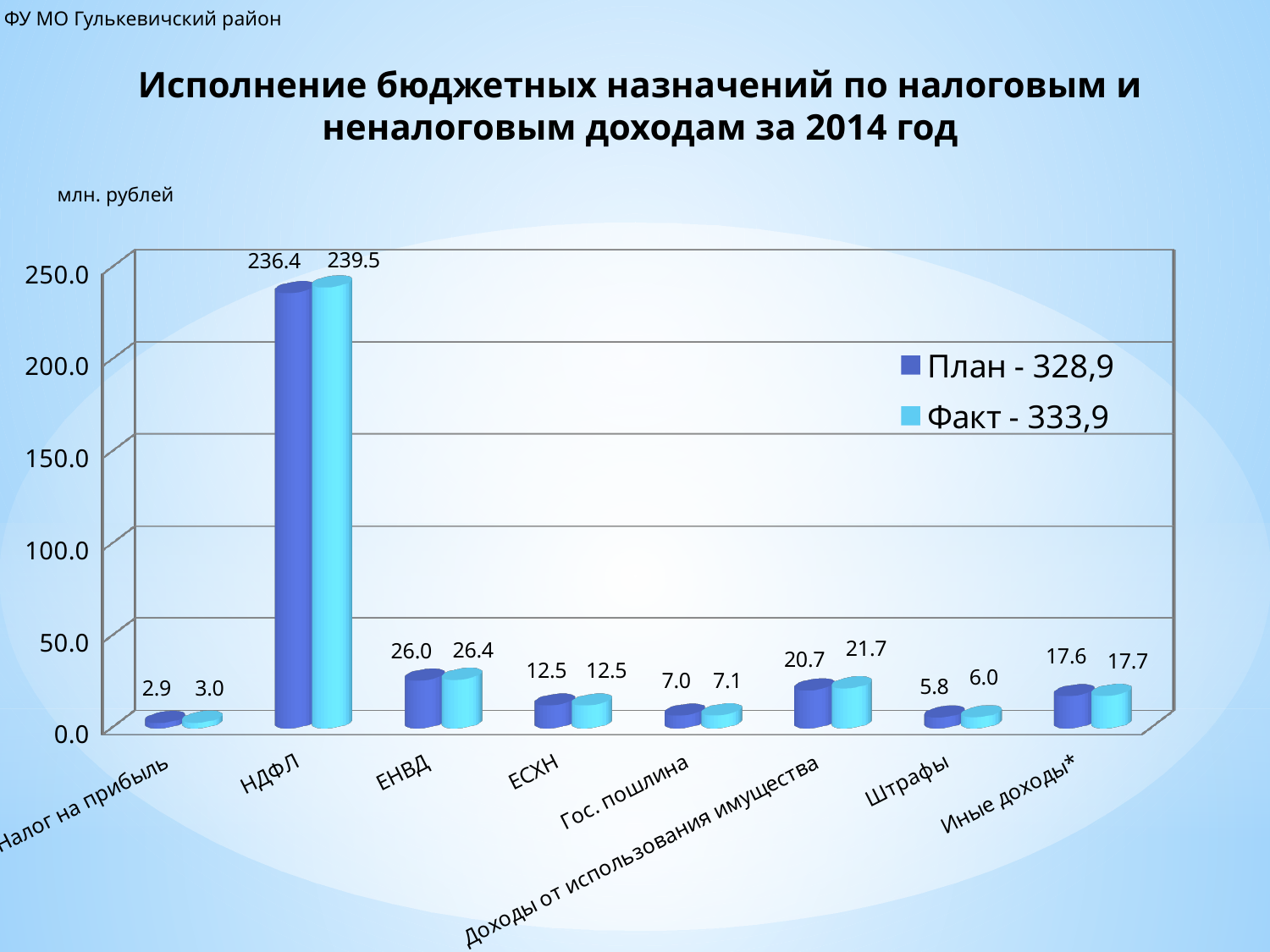
What is the Факт value for Доходы от использования имущества? 21.7 How many series does the legend list? 2 Which category has the lowest План value? Налог на прибыль What is the difference between the Факт and План values for НДФЛ? 3.1 What is the План value for НДФЛ? 236.4 Is the Факт value for НДФЛ greater or less than 200.0? greater What type of chart is shown on the slide? bar chart How many categories are shown on the x axis? 8 What is the Факт value for Иные доходы*? 17.7 What is the План value for Штрафы? 5.8 Which category has the highest Факт value? НДФЛ Which is larger for ЕНВД, the План value or the Факт value? Факт